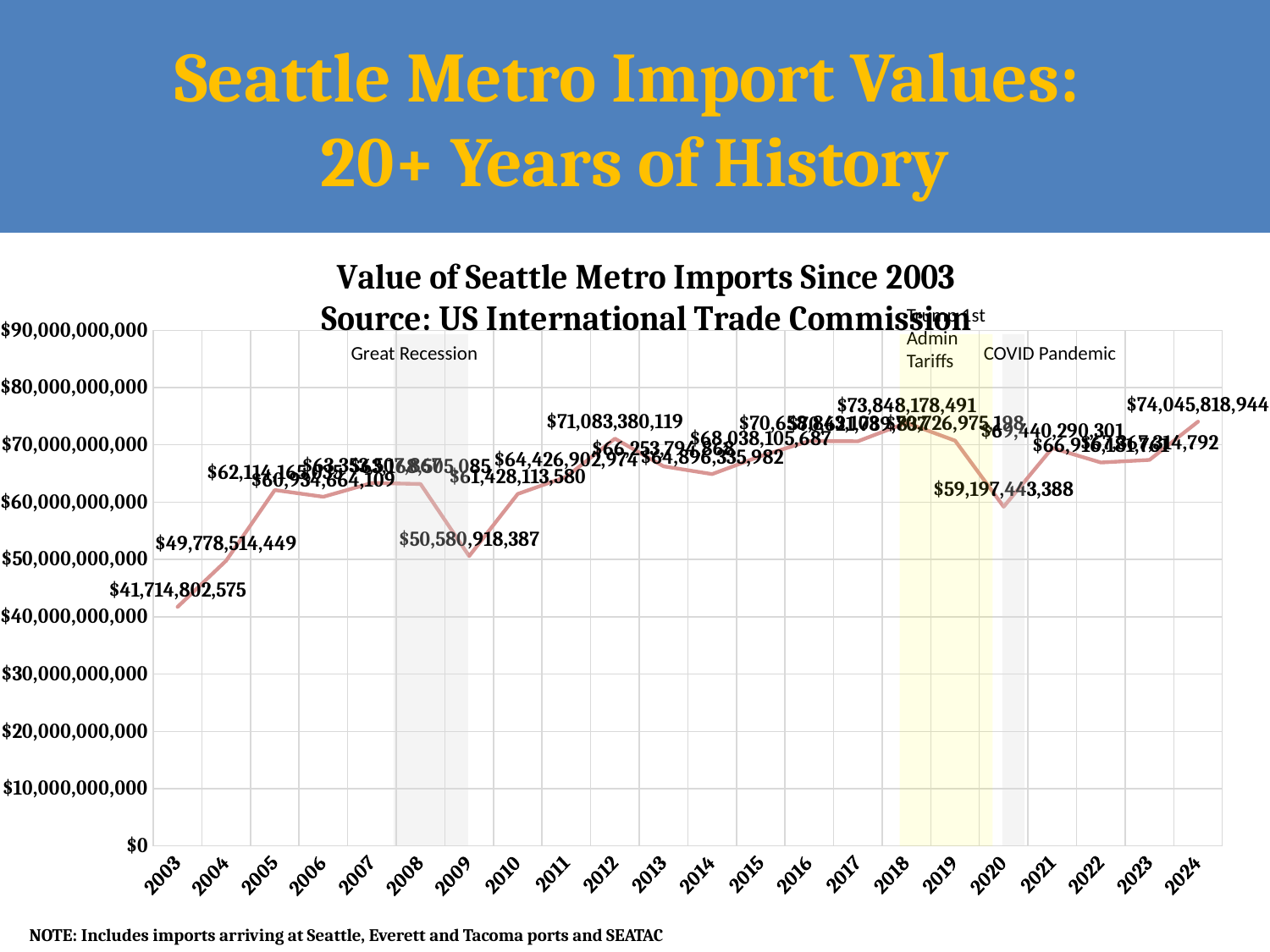
How much higher is the 2024 import value than the 2003 import value? $32,331,016,369 Which year has the highest import value on the chart? 2024 Which year had a larger import value, 2011 or 2010? 2011 What was the value of Seattle Metro imports in 2024? $74,045,818,944 What type of chart is shown on the slide? line chart What was the value of Seattle Metro imports in 2009? $50,580,918,387 By how much did the import value increase from 2009 to 2010? $10,847,195,193 How many years are plotted on the x axis? 22 What was the value of Seattle Metro imports in 2003? $41,714,802,575 Which year has the lowest import value on the chart? 2003 What was the value of Seattle Metro imports in 2020? $59,197,443,388 Is the import value for 2013 greater or less than $70,000,000,000? less